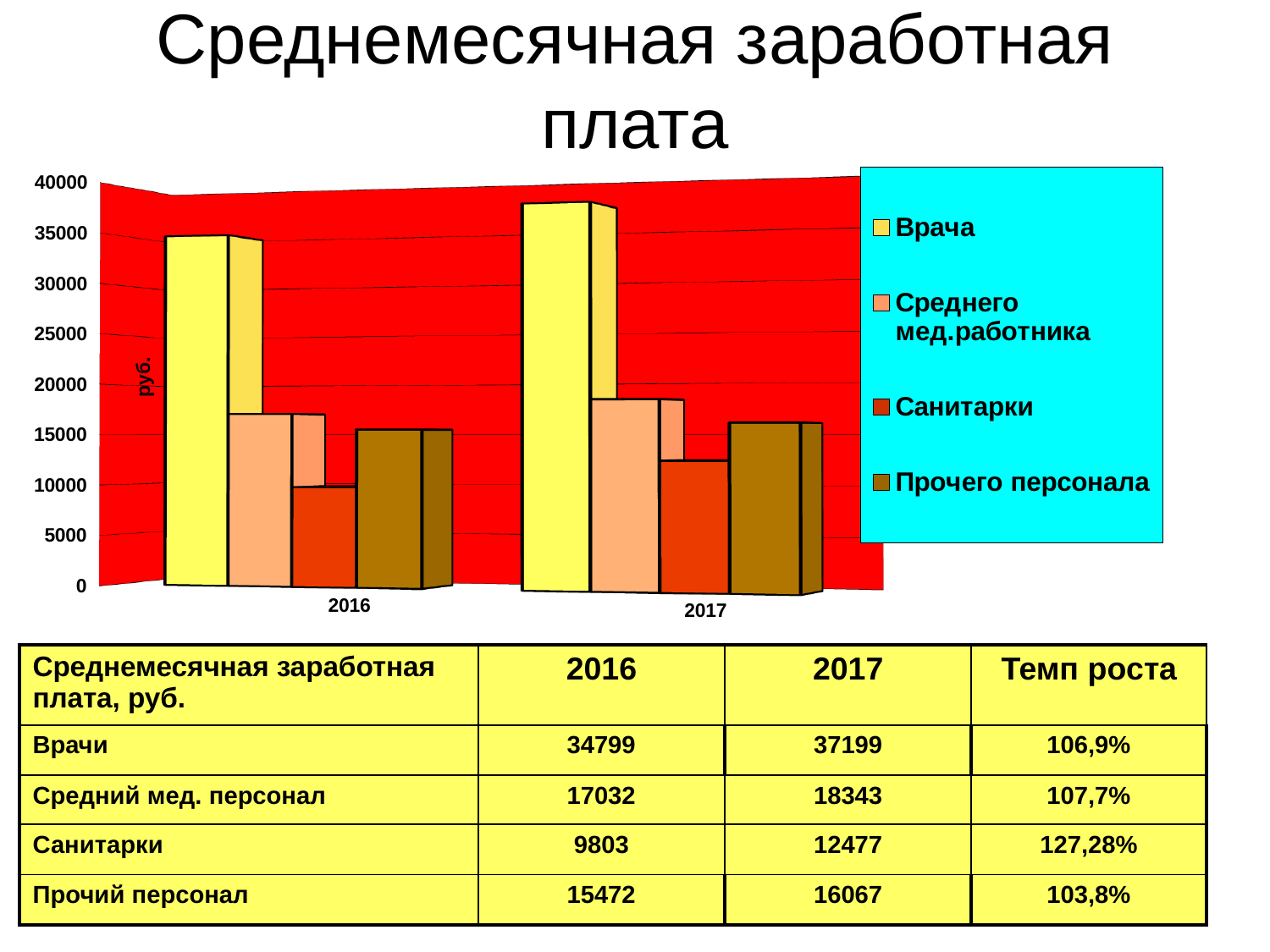
How many series does the chart legend list? 4 Which series has the highest bar in 2017? Врача How many year categories are shown on the x axis of the chart? 2 Is the value for Санитарки in 2016 greater or less than 10000? less What unit label is shown on the vertical axis of the chart? руб. Which is larger: the bar for Среднего мед.работника in 2016 or the bar for Прочего персонала in 2016? Среднего мед.работника in 2016 Is the value for Врача in 2017 greater or less than 35000? greater What kind of chart is shown on the slide? bar chart According to the table on the slide, what is the average monthly salary of Врачи in 2017? 37199 Is the value for Прочего персонала in 2017 greater or less than 15000? greater Do the bars for Санитарки rise or fall from 2016 to 2017? rise Which series has the lowest bar in 2016? Санитарки